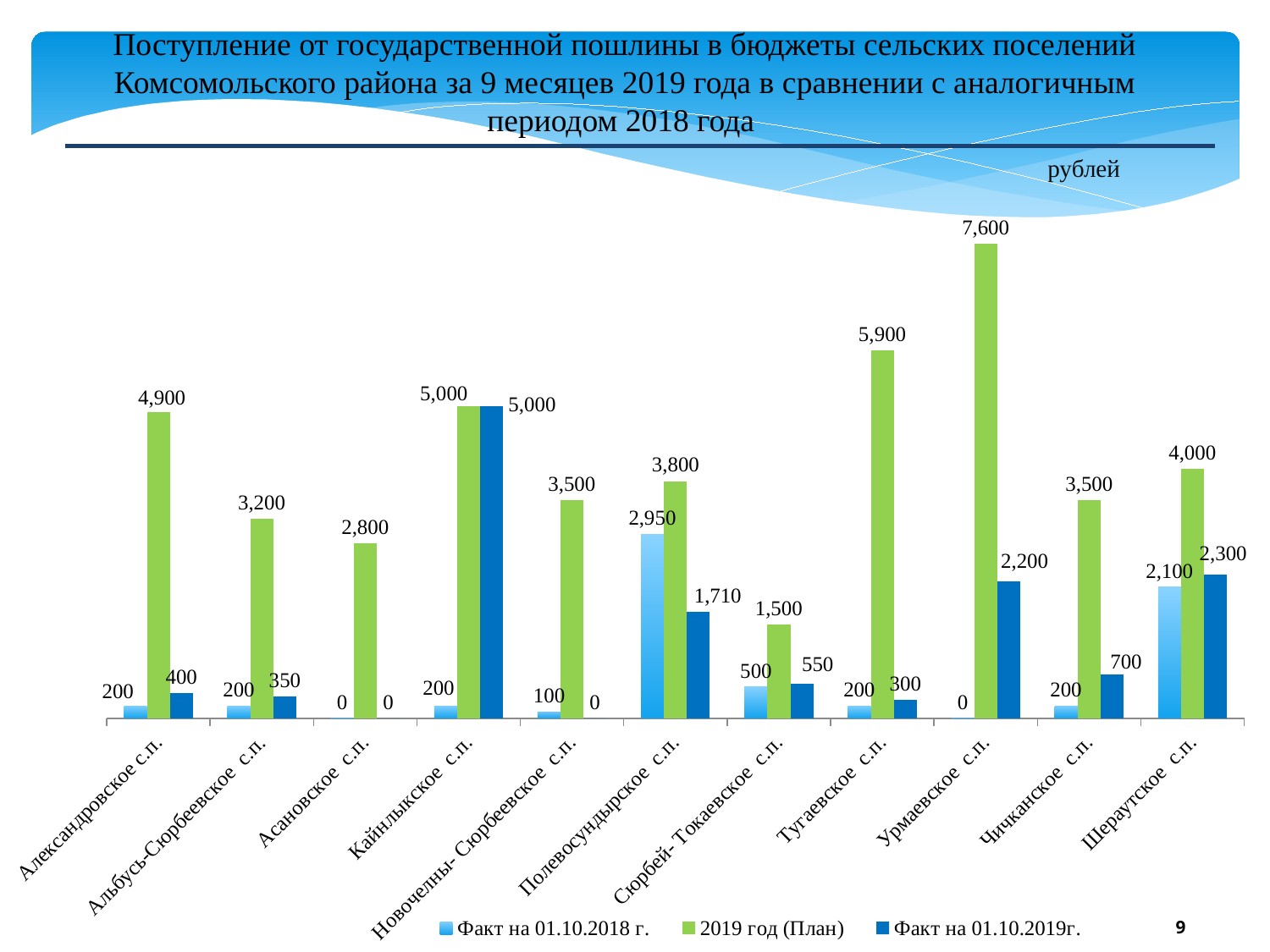
How many series does the legend list? 3 Which settlement has the lowest 2019 год (План) value? Сюрбей-Токаевское с.п. What is the Факт на 01.10.2019г. value for Кайнлыкское с.п.? 5,000 What kind of chart is shown on the slide? Bar chart What is the Факт на 01.10.2019г. value for Полевосундырское с.п.? 1,710 Which is larger for Шераутское с.п.: the Факт на 01.10.2018 г. value or the Факт на 01.10.2019г. value? Факт на 01.10.2019г. What unit is indicated above the chart? рублей What is the 2019 год (План) value for Урмаевское с.п.? 7,600 How many settlements are shown on the x axis? 11 What is the Факт на 01.10.2018 г. value for Шераутское с.п.? 2,100 Which settlement has the highest 2019 год (План) value? Урмаевское с.п. What is the difference between the 2019 год (План) value and the Факт на 01.10.2019г. value for Тугаевское с.п.? 5,600